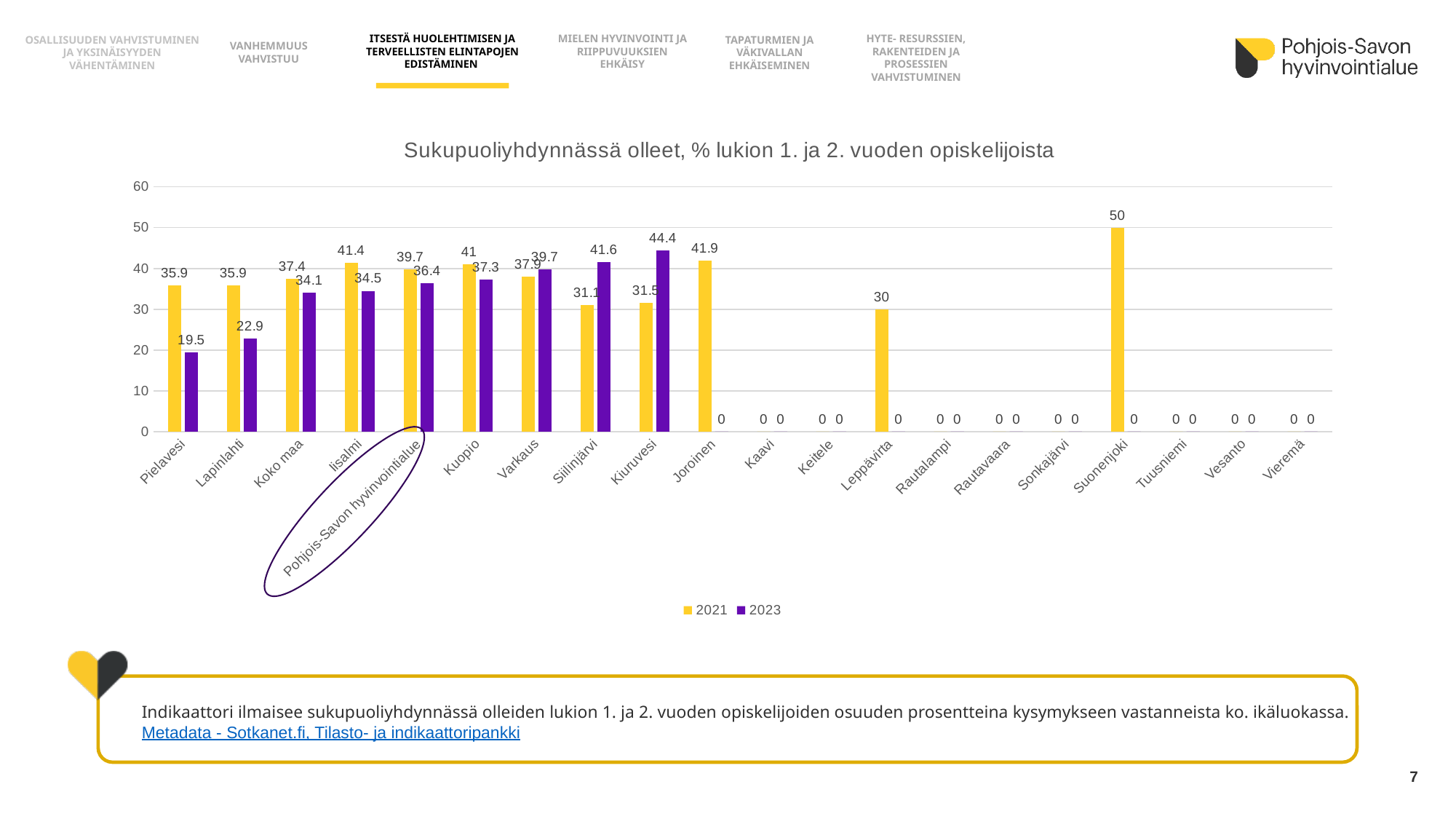
What is the difference between the 2021 and 2023 values for Koko maa? 3.3 Among the categories with a non-zero 2023 value, which has the lowest 2023 value? Pielavesi Which category has the highest 2021 value? Suonenjoki How many categories are shown on the x axis? 20 What is the 2023 value for Kiuruvesi? 44.4 What is the 2021 value for Leppävirta? 30 What is the difference between the 2021 and 2023 values for Pielavesi? 16.4 What is the 2021 value for Kuopio? 41 What kind of chart is shown on the slide? Bar chart How many series does the legend list? 2 Which category has the highest 2023 value? Kiuruvesi For Siilinjärvi, which is larger: the 2021 value or the 2023 value? 2023